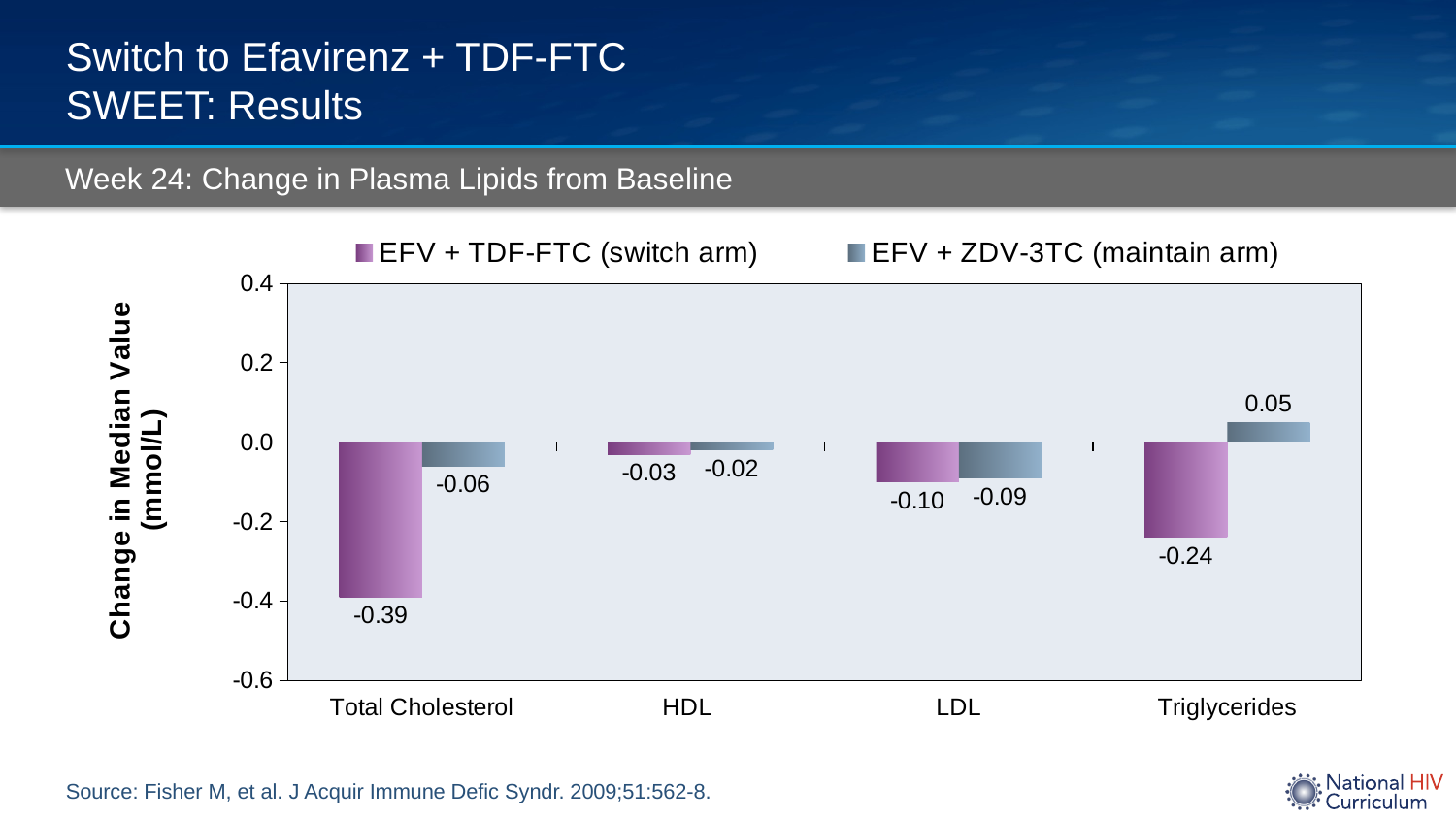
Which category has the lowest value in the EFV + TDF-FTC (switch arm) series? Total Cholesterol How many series does the legend list? 2 What is the change in median value for Total Cholesterol in the EFV + TDF-FTC (switch arm)? -0.39 What is the difference between the switch arm and maintain arm values for Total Cholesterol? 0.33 How many lipid categories are shown on the x axis? 4 What kind of chart is shown on the slide? Bar chart For Total Cholesterol, which arm has the larger (less negative) change in median value? EFV + ZDV-3TC (maintain arm) What is the difference between the switch arm and maintain arm values for Triglycerides? 0.29 What is the change in median value for HDL in the EFV + TDF-FTC (switch arm)? -0.03 What is the change in median value for LDL in the EFV + ZDV-3TC (maintain arm)? -0.09 What is the change in median value for Triglycerides in the EFV + ZDV-3TC (maintain arm)? 0.05 Which category has the highest value in the EFV + ZDV-3TC (maintain arm) series? Triglycerides